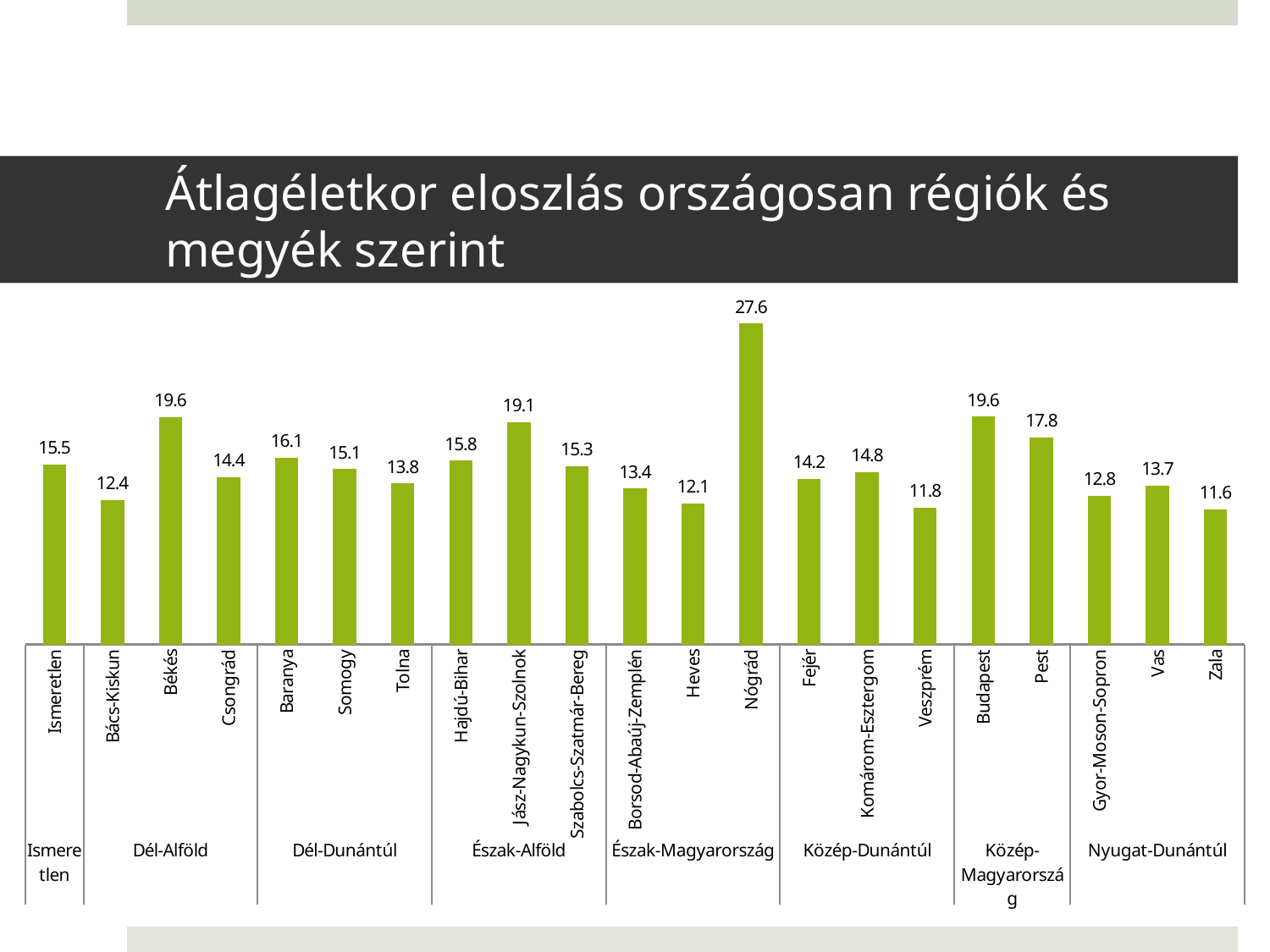
What is the value for Jász-Nagykun-Szolnok? 19.1 What is the value for Nógrád? 27.6 Which is larger, the value for Baranya or the value for Tolna? Baranya What kind of chart is shown on the slide? Bar chart What is the value for Veszprém? 11.8 What is the difference between the values for Nógrád and Heves? 15.5 Which is larger, the value for Fejér or the value for Komárom-Esztergom? Komárom-Esztergom Which county has the lowest value? Zala Which county has the highest value? Nógrád What is the title of the chart? Átlagéletkor eloszlás országosan régiók és megyék szerint What is the difference between the values for Budapest and Pest? 1.8 How many bars are plotted in the chart? 21